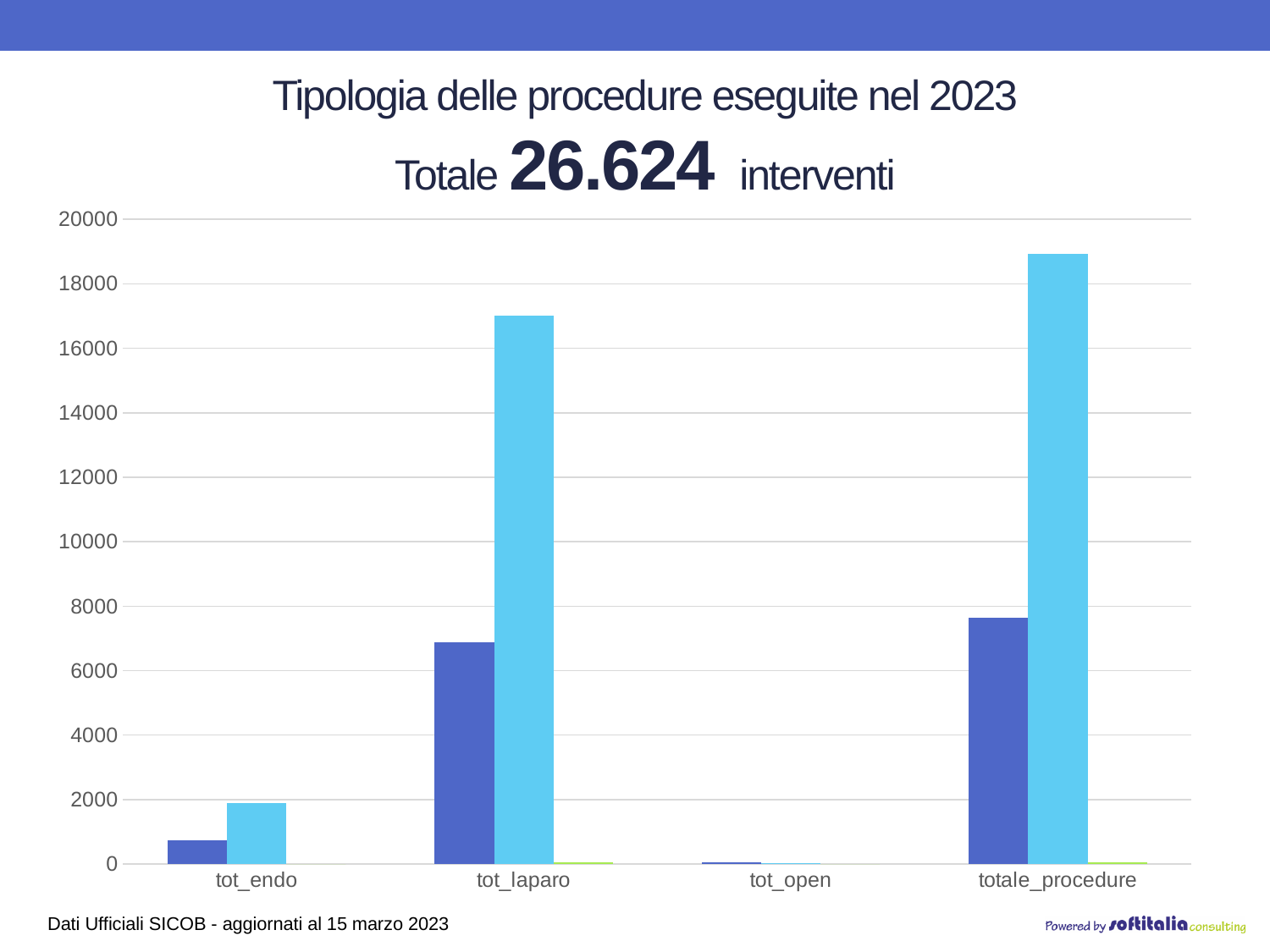
How many categories are shown on the x axis of the chart? 4 Is the light blue bar for tot_laparo greater or less than 16000? greater Is the dark blue bar for tot_endo greater or less than 1000? less What kind of chart is shown on the slide? bar chart Is the dark blue bar for tot_laparo greater or less than 8000? less What total number of interventions is stated in the chart title? 26.624 Which category has the shortest light blue bar? tot_open Which category has the tallest dark blue bar? totale_procedure For tot_laparo, which bar is taller, the dark blue one or the light blue one? light blue Which category has the tallest light blue bar? totale_procedure